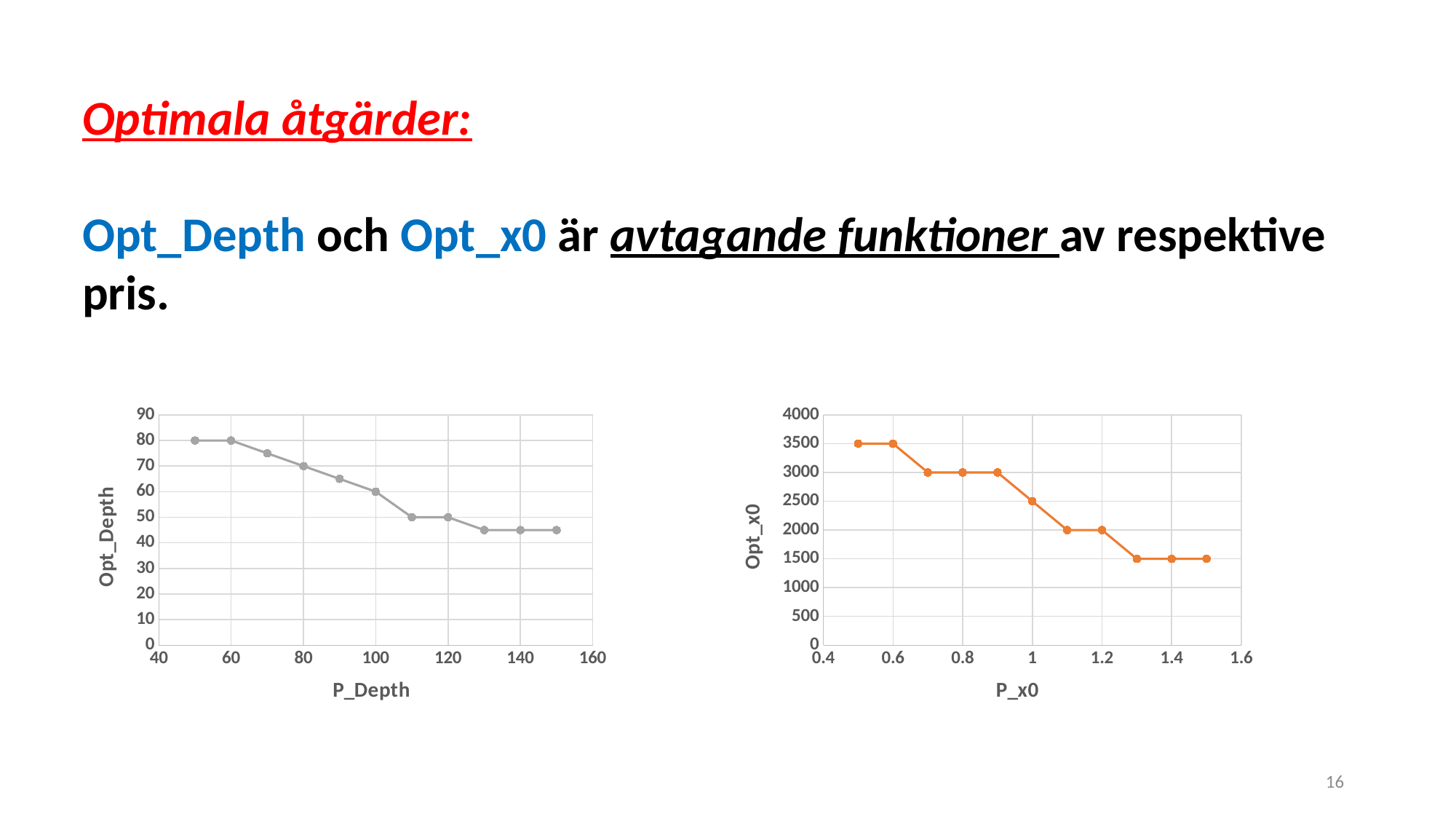
In the left chart (Opt_Depth vs P_Depth), what is the value of Opt_Depth when P_Depth is 100? 60 In the left chart (Opt_Depth vs P_Depth), do the values rise or fall as P_Depth increases? fall In the right chart (Opt_x0 vs P_x0), what is the value of Opt_x0 when P_x0 is 1.4? 1500 In the right chart (Opt_x0 vs P_x0), what is the difference between Opt_x0 at P_x0 0.6 and at P_x0 1.4? 2000 In the left chart (Opt_Depth vs P_Depth), is the value of Opt_Depth at P_Depth 140 greater or less than 50? less What kind of chart is the left chart (Opt_Depth vs P_Depth)? line chart What is the x-axis label of the right chart? P_x0 In the right chart (Opt_x0 vs P_x0), what is the highest plotted value of Opt_x0? 3500 In the right chart (Opt_x0 vs P_x0), what is the value of Opt_x0 when P_x0 is 1? 2500 In the left chart (Opt_Depth vs P_Depth), what is the value of Opt_Depth when P_Depth is 120? 50 How many data points are plotted in the left chart (Opt_Depth vs P_Depth)? 11 In the left chart (Opt_Depth vs P_Depth), what is the value of Opt_Depth when P_Depth is 80? 70